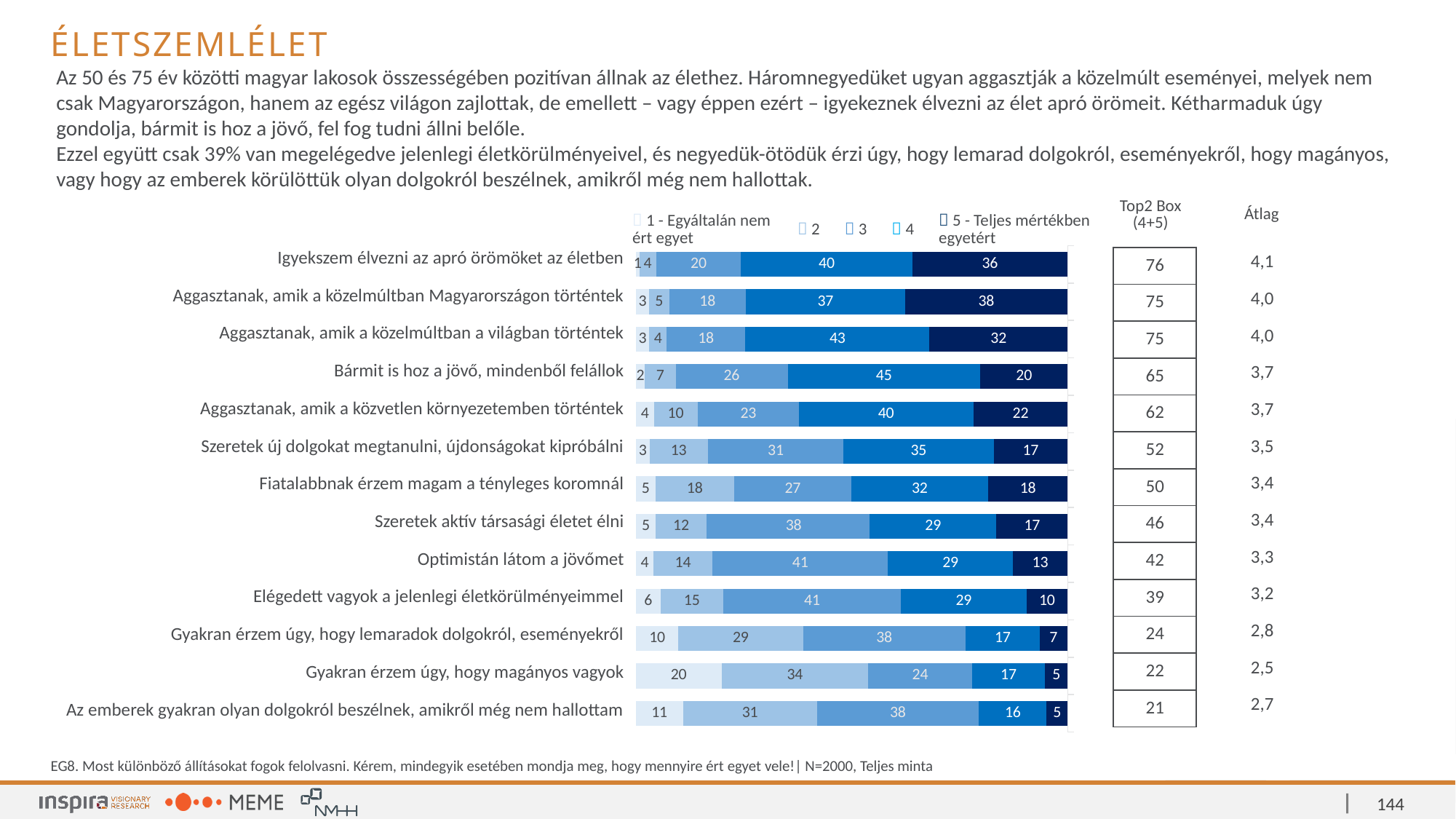
Which has the larger series "3" value: "Szeretek aktív társasági életet élni" or "Fiatalabbnak érzem magam a tényleges koromnál"? Szeretek aktív társasági életet élni What is the value of "5 - Teljes mértékben egyetért" for "Igyekszem élvezni az apró örömöket az életben"? 36 How many series does the chart legend list? 5 What kind of chart is shown on the slide? bar chart What is the value of series "3" for "Elégedett vagyok a jelenlegi életkörülményeimmel"? 41 What is the value of series "2" for "Gyakran érzem úgy, hogy lemaradok dolgokról, eseményekről"? 29 How many statements (categories) are plotted in the chart? 13 What is the value of series "4" for "Bármit is hoz a jövő, mindenből felállok"? 45 Which statement has the highest value for "5 - Teljes mértékben egyetért"? Aggasztanak, amik a közelmúltban Magyarországon történtek What is the total of the stacked bar for "Gyakran érzem úgy, hogy magányos vagyok"? 100 Which statement has the highest value for "1 - Egyáltalán nem ért egyet"? Gyakran érzem úgy, hogy magányos vagyok What is the difference between the series "4" value for "Igyekszem élvezni az apró örömöket az életben" and for "Optimistán látom a jövőmet"? 11